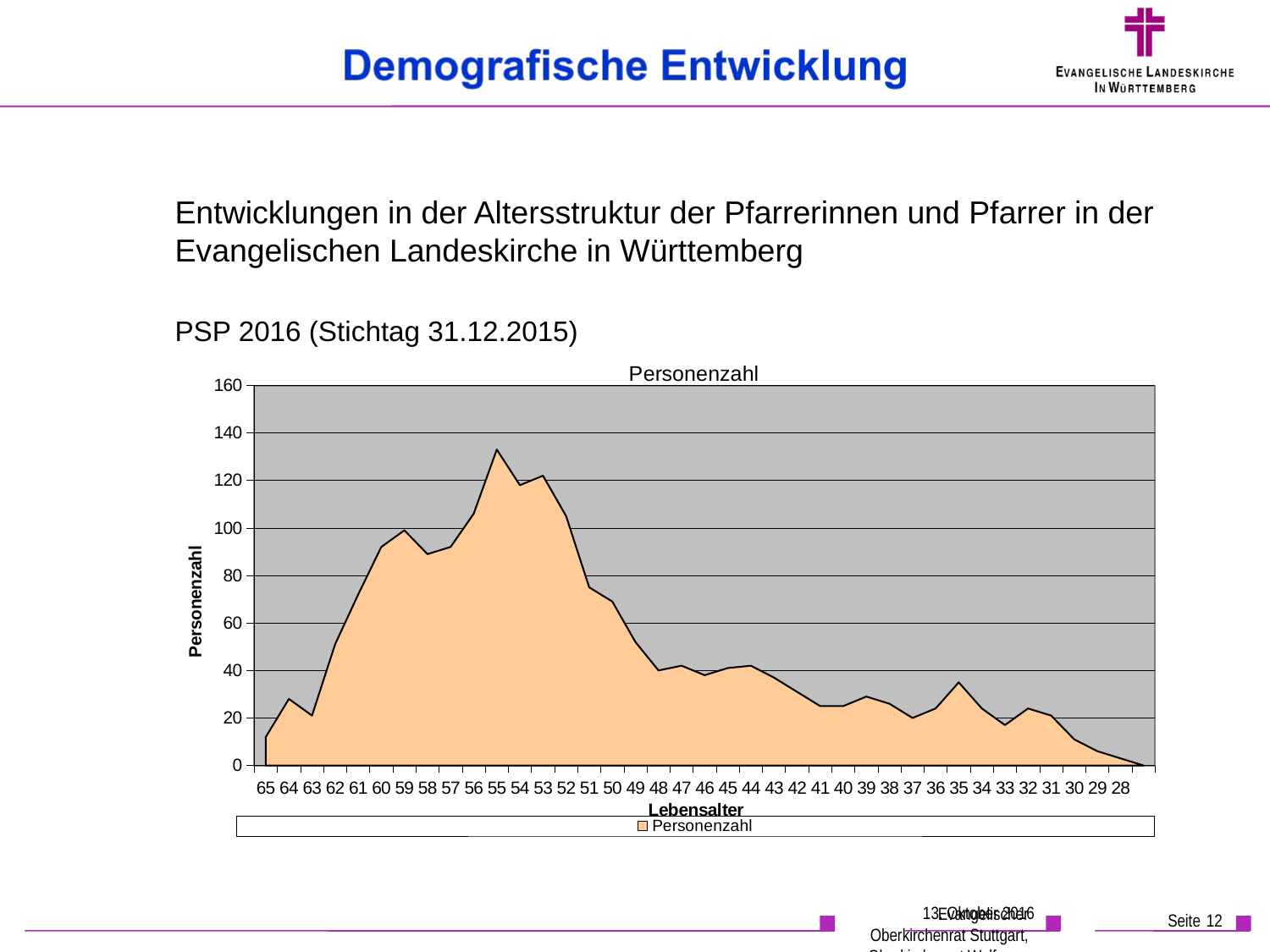
Which age has the larger Personenzahl, 55 or 45? 55 Is the value for age 65 greater or less than 20? less Do the values generally rise or fall from age 55 to age 28 along the x axis? fall How many age categories are shown on the x axis? 38 What is the label of the x axis of the chart? Lebensalter What kind of chart is shown on the slide? area chart Is the value for age 55 greater or less than 120? greater What is the title of the chart? Personenzahl At which age (Lebensalter) is the Personenzahl highest? 55 At which age (Lebensalter) is the Personenzahl lowest? 28 How many series does the legend list? 1 Is the value for age 60 greater or less than 80? greater